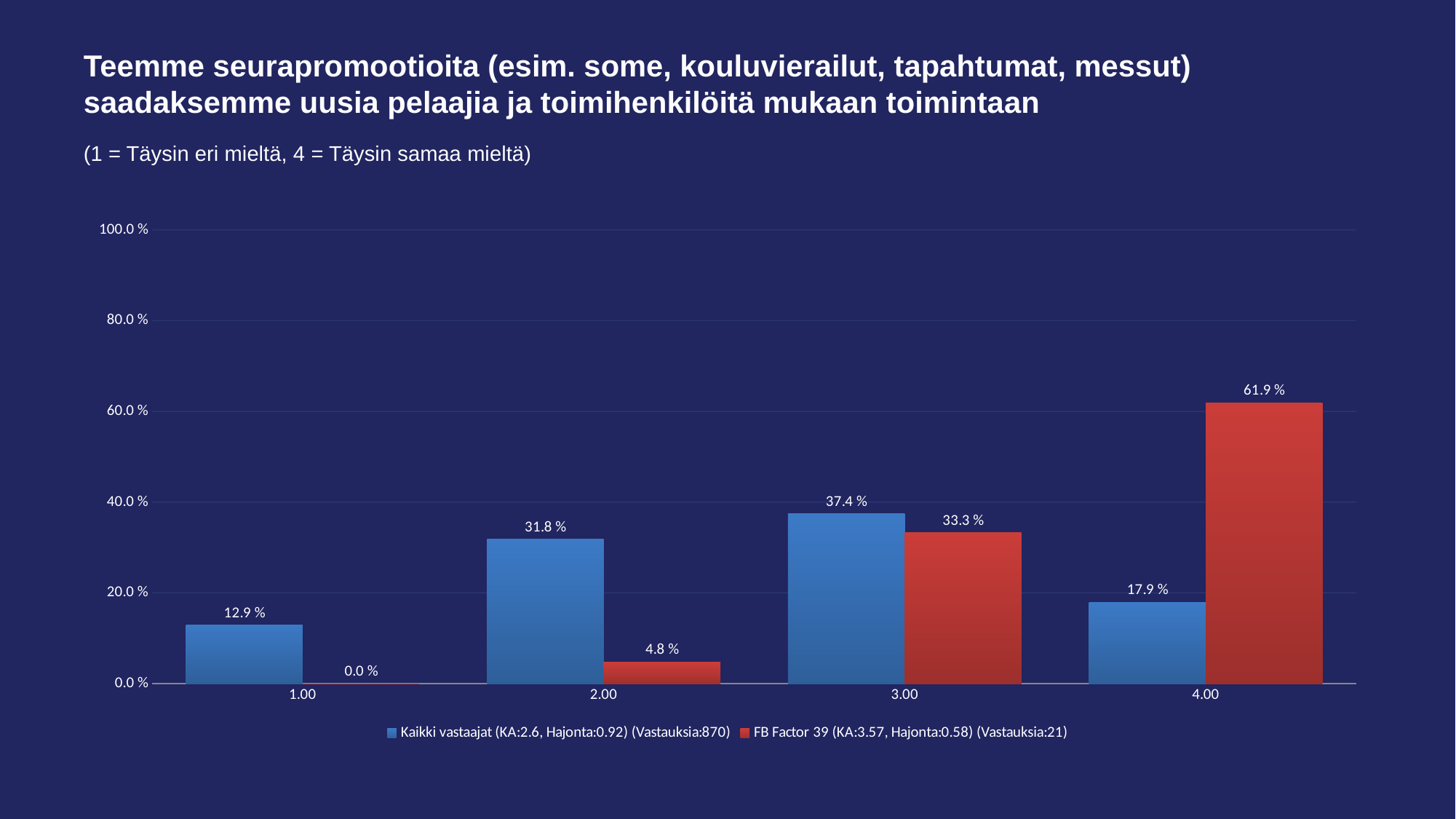
Is the value for FB Factor 39 at category 4.00 greater or less than 60.0 %? greater At category 2.00, which series has the larger value, Kaikki vastaajat or FB Factor 39? Kaikki vastaajat How many series does the legend list? 2 How many categories are shown on the x axis? 4 What kind of chart is shown on the slide? Bar chart What is the value for Kaikki vastaajat at category 2.00? 31.8 % What is the value for FB Factor 39 at category 1.00? 0.0 % What is the difference between the FB Factor 39 and Kaikki vastaajat values at category 4.00? 44.0 % Which category has the highest value for FB Factor 39? 4.00 What is the value for Kaikki vastaajat at category 3.00? 37.4 % Which category has the lowest value for Kaikki vastaajat? 1.00 What is the value for FB Factor 39 at category 4.00? 61.9 %